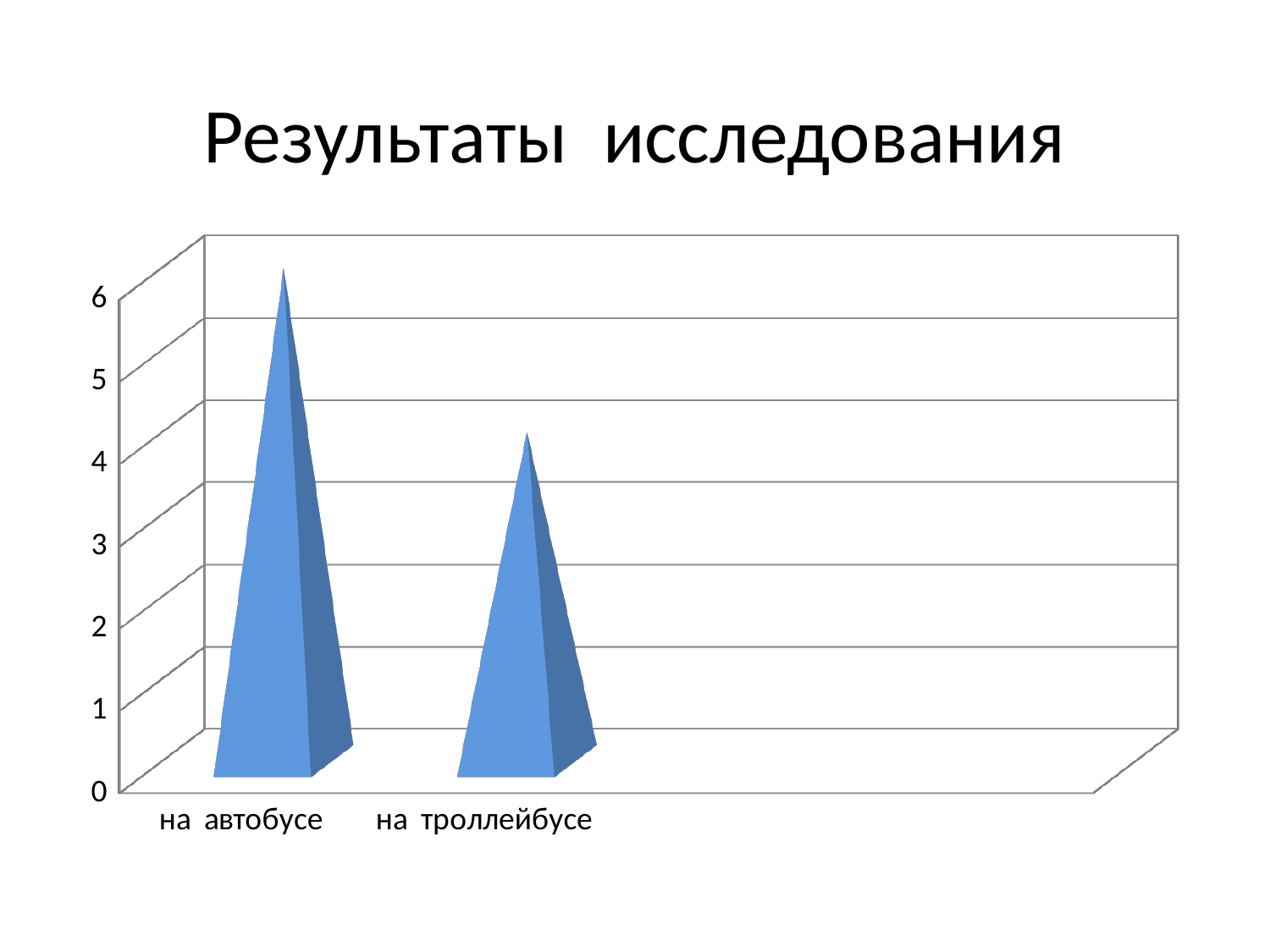
Is the value for "на автобусе" greater or less than 5? greater How many categories are shown on the x axis of the chart? 2 Which category has the highest value in the chart? на автобусе What colour are the bars in the chart? blue Which is larger, the value for "на автобусе" or the value for "на троллейбусе"? на автобусе Is the value for "на троллейбусе" greater or less than 5? less What is the title of the slide containing the chart? Результаты исследования Is the value for "на троллейбусе" greater or less than 3? greater Do the values rise or fall from "на автобусе" to "на троллейбусе"? fall What is the highest value shown on the vertical axis of the chart? 6 What kind of chart is shown on the slide? bar chart Which category has the lowest value in the chart? на троллейбусе